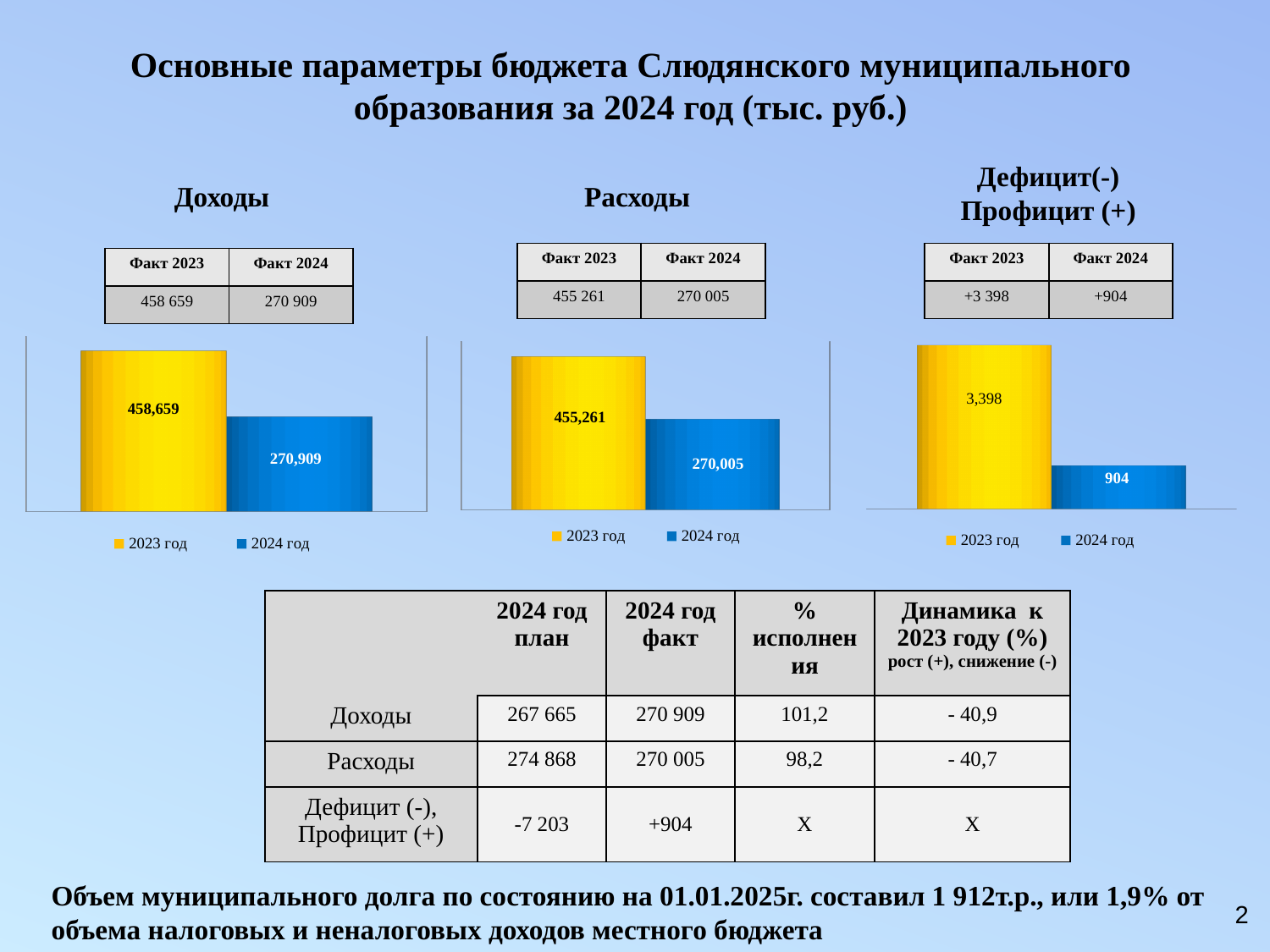
In the Доходы chart, what is the difference between the 2023 год and 2024 год values? 187,750 In the Дефицит(-) Профицит (+) chart, which year has the higher value? 2023 год In the Расходы chart, what is the difference between the 2023 год and 2024 год values? 185,256 In the Расходы chart, what is the value for 2024 год? 270,005 How many series does the legend of the Доходы chart list? 2 In the Расходы chart, is the value for 2023 год larger or smaller than the value for 2024 год? larger In the Доходы chart, what is the value for 2023 год? 458,659 In the Расходы chart, what is the value for 2023 год? 455,261 In the Доходы chart, what is the value for 2024 год? 270,909 What type of chart is the Расходы chart? bar chart In the Дефицит(-) Профицит (+) chart, what is the value for 2024 год? 904 In the Дефицит(-) Профицит (+) chart, what is the difference between the 2023 год and 2024 год values? 2,494